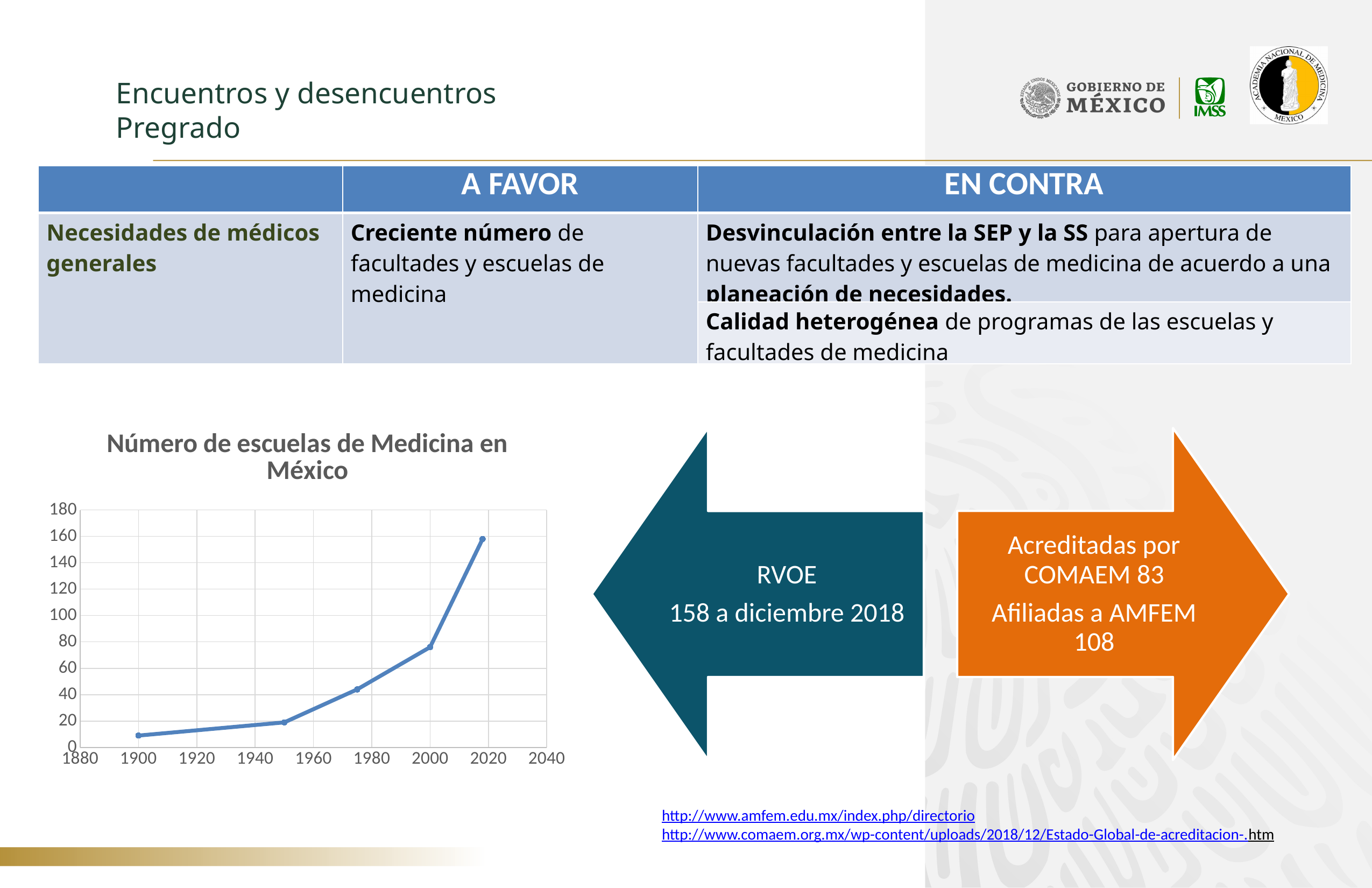
In the "Número de escuelas de Medicina en México" chart, is the value for 1900 greater or less than 20? less In the "Número de escuelas de Medicina en México" chart, do the values rise or fall as the years increase? rise What kind of chart is "Número de escuelas de Medicina en México"? line chart What is the title of the chart on the slide? Número de escuelas de Medicina en México What is the highest value shown on the vertical axis of the "Número de escuelas de Medicina en México" chart? 180 In the "Número de escuelas de Medicina en México" chart, is the value for 2000 larger or smaller than the value for 1900? larger In the "Número de escuelas de Medicina en México" chart, is the value of the rightmost point greater or less than 140? greater In the "Número de escuelas de Medicina en México" chart, which point has the highest value, the one at 1900 or the rightmost one? the rightmost one In the "Número de escuelas de Medicina en México" chart, is the value for 2000 greater or less than 60? greater In the "Número de escuelas de Medicina en México" chart, which plotted point has the lowest value? 1900 How many data points are plotted in the "Número de escuelas de Medicina en México" chart? 5